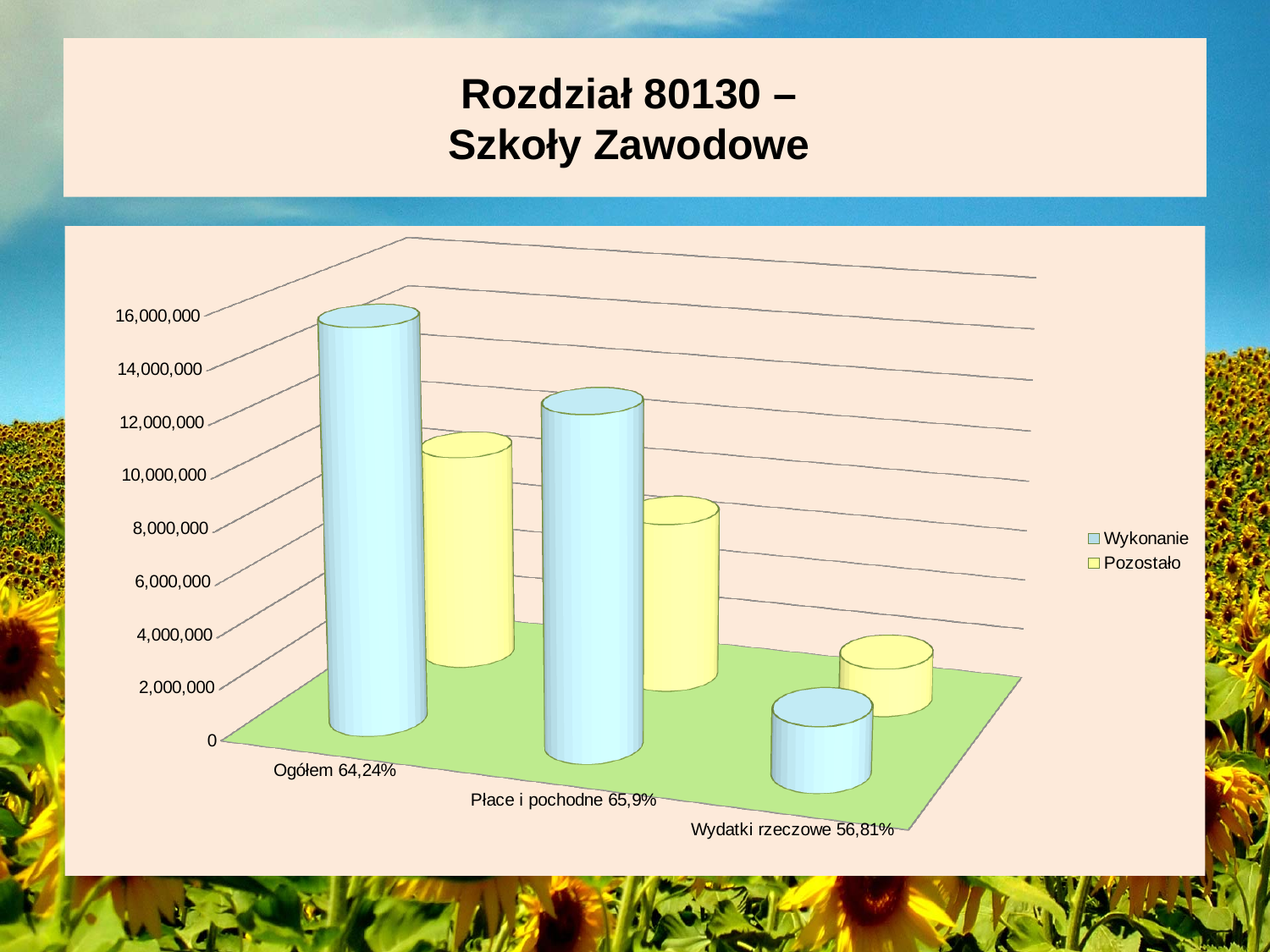
Do the Wykonanie values rise or fall from Ogółem to Wydatki rzeczowe along the x axis? fall How many series does the legend list? 2 Which category has the highest Wykonanie value? Ogółem 64,24% Is the Wykonanie value for Wydatki rzeczowe 56,81% greater or less than 6,000,000? less Which category has the lowest Pozostało value? Wydatki rzeczowe 56,81% What kind of chart is shown on the slide? bar chart How many categories are shown on the x axis? 3 Which category has the lowest Wykonanie value? Wydatki rzeczowe 56,81% For Ogółem 64,24%, which is larger: Wykonanie or Pozostało? Wykonanie Is the Pozostało value for Ogółem 64,24% greater or less than 14,000,000? less Is the Wykonanie value for Ogółem 64,24% greater or less than 10,000,000? greater What is the title of the slide containing the chart? Rozdział 80130 – Szkoły Zawodowe